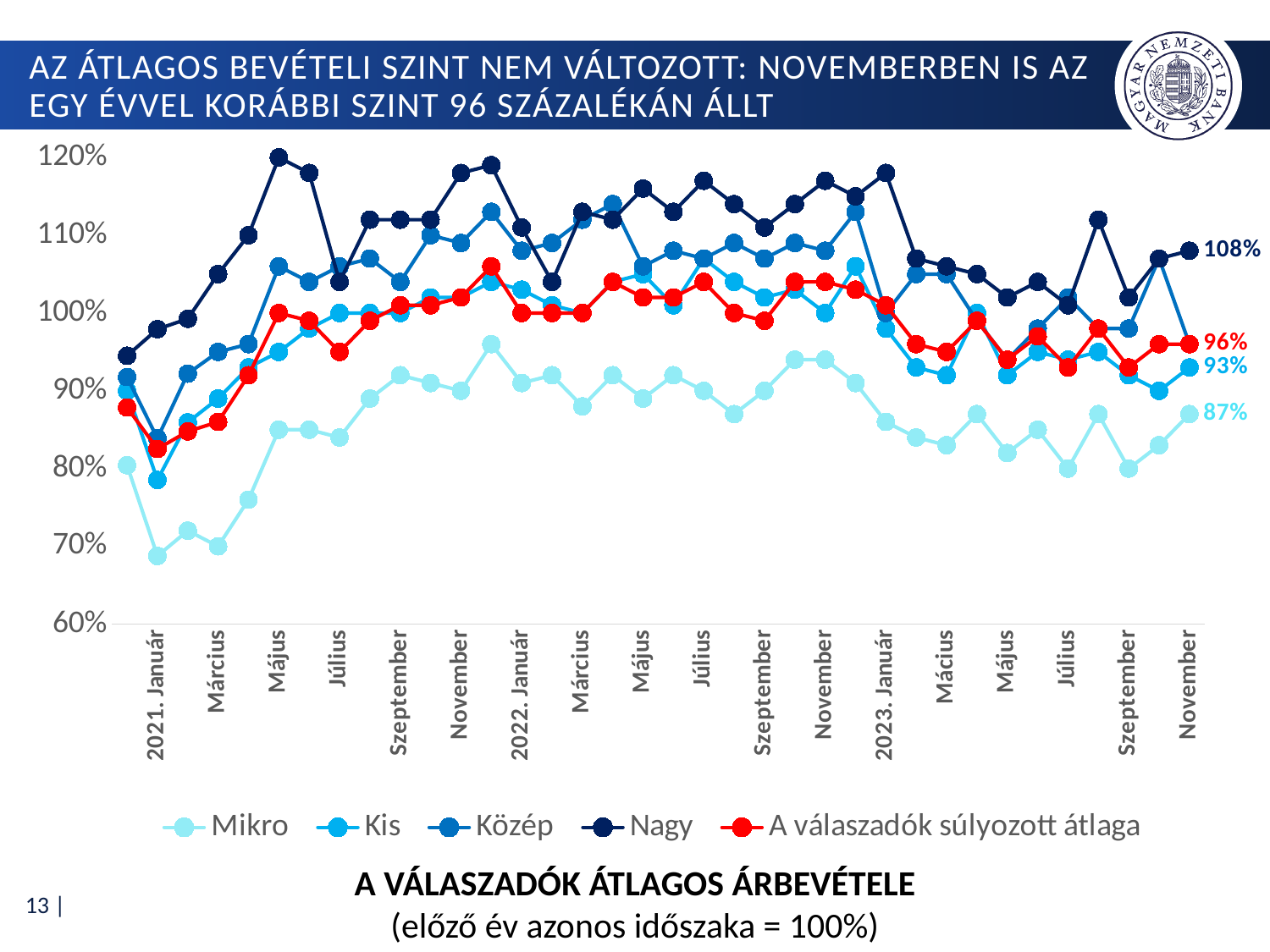
Which legend entry corresponds to the red line? A válaszadók súlyozott átlaga What is the value of the Nagy series in November 2023? 108% What is the difference between the Nagy and Mikro values in November 2023? 21 percentage points Which series has the lowest value in November 2023? Mikro What is the value of the Mikro series in November 2023? 87% What is the value of the Kis series in November 2023? 93% Is the value for Mikro in 2021. Január greater or less than 90%? less How many series does the legend list? 5 What is the value of 'A válaszadók súlyozott átlaga' in November 2023? 96% Is the value for Nagy in Május 2021 greater or less than 110%? greater Which series has the highest value in November 2023? Nagy What kind of chart is shown on the slide? line chart